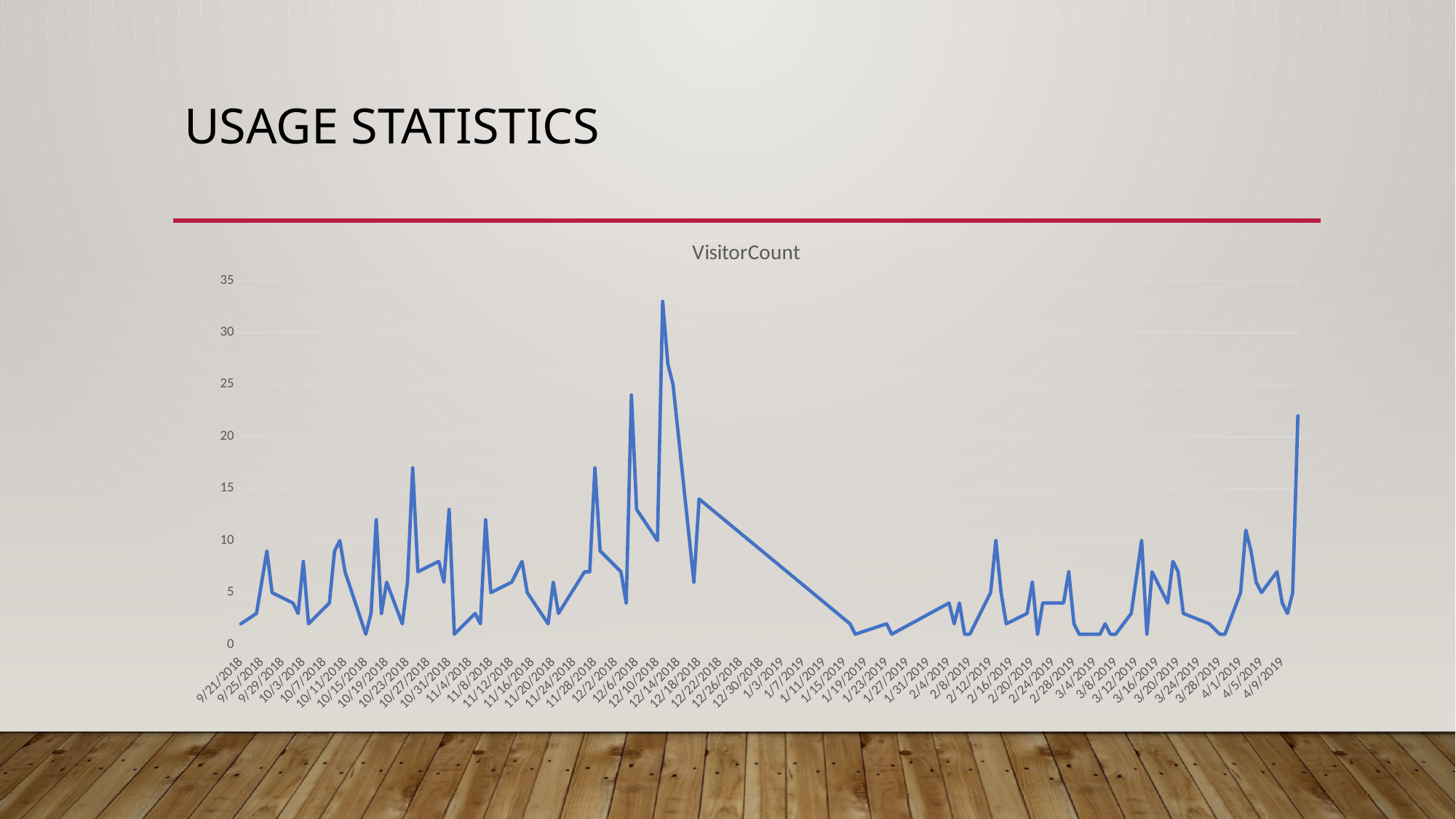
What kind of chart is shown on the slide? line chart Between 12/22/2018 and 1/19/2019, do the values rise or fall? fall What is the highest value shown on the vertical axis? 35 Is the value for 9/21/2018 greater or less than 5? less Is the highest value reached by the line greater or less than 35? less Which is larger, the value for 4/9/2019 or the value for 9/21/2018? 4/9/2019 What is the first date label on the horizontal axis? 9/21/2018 Is the value for 4/9/2019 greater or less than 25? less What is the title of the chart? VisitorCount